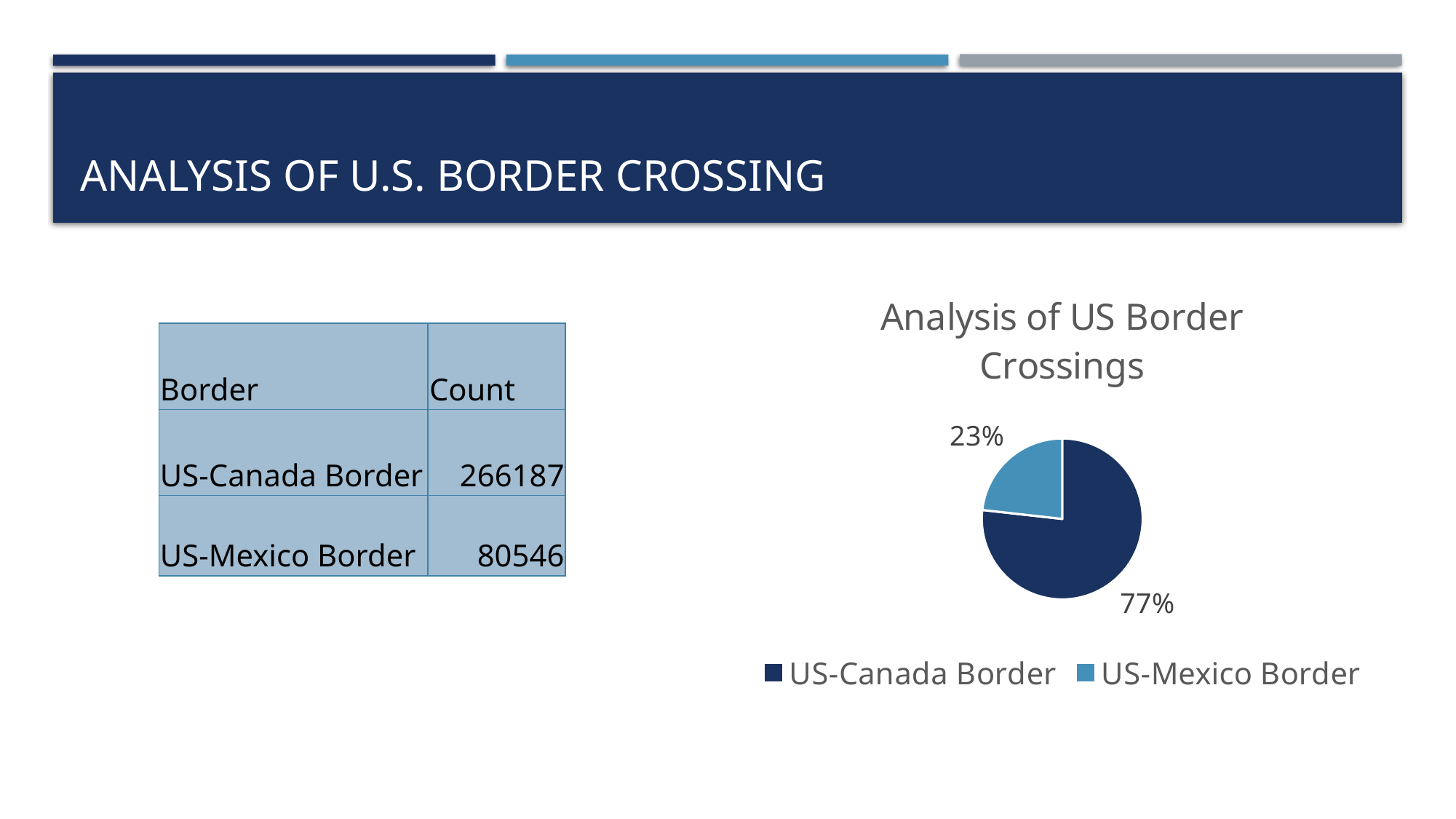
What is the title of the chart? Analysis of US Border Crossings What type of chart is shown on the slide? pie chart How many entries does the legend list? 2 Which border has the largest slice of the pie? US-Canada Border Which is larger, the share for US-Canada Border or the share for US-Mexico Border? US-Canada Border How many slices does the pie chart have? 2 Which border has the smallest slice of the pie? US-Mexico Border What is the difference in percentage points between the US-Canada Border share and the US-Mexico Border share? 54 What share of the pie does US-Canada Border represent? 77% Which colour represents US-Mexico Border in the pie chart? light blue What share of the pie does US-Mexico Border represent? 23%